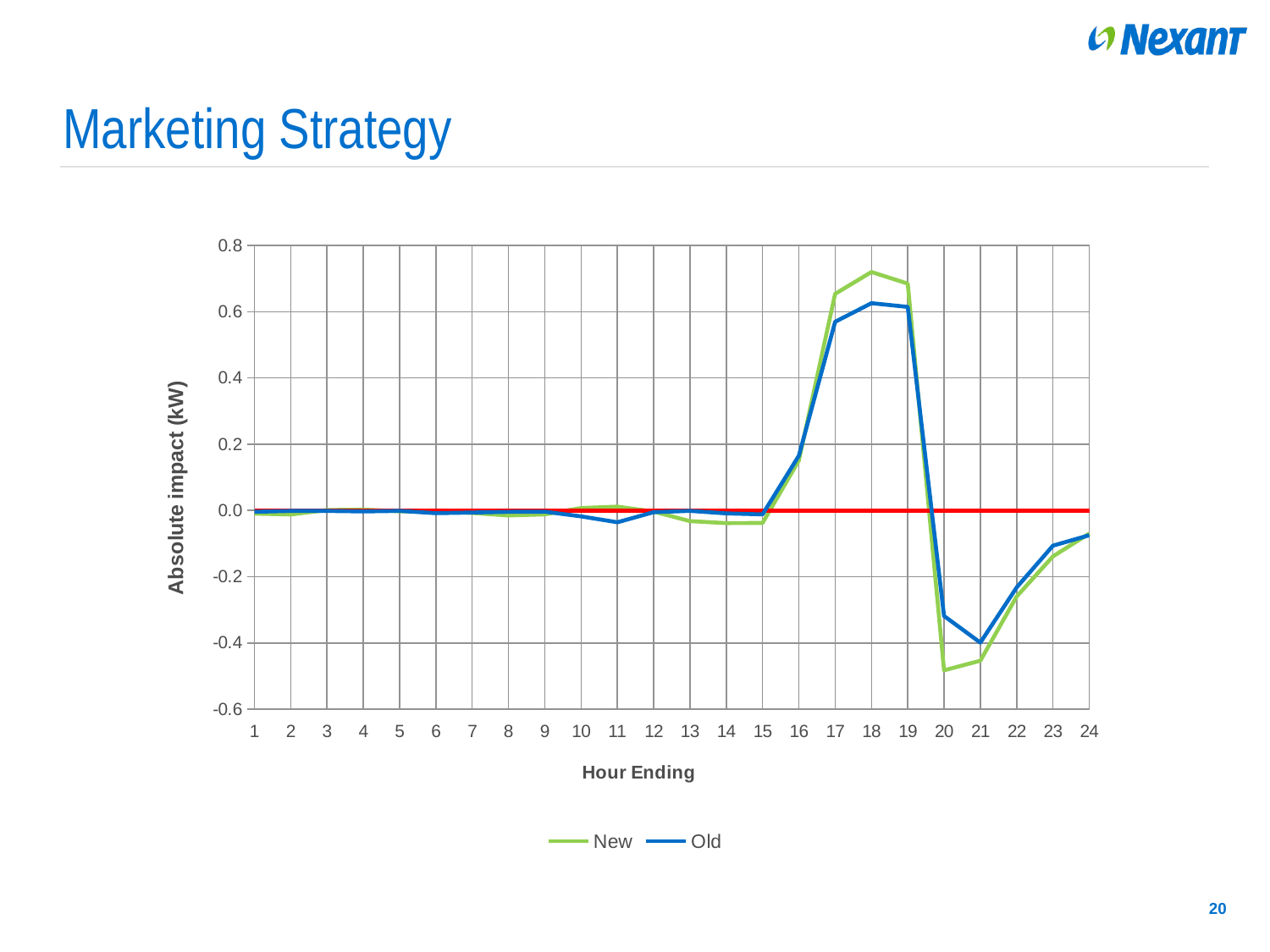
What is the title of the x axis? Hour Ending At hour ending 18, which series has the larger value, New or Old? New At which hour ending does the Old series reach its lowest value? 21 What kind of chart is shown on the slide? Line chart At which hour ending does the New series reach its highest value? 18 Is the value for the New series at hour ending 20 greater or less than -0.4? less Do the values of the New series rise or fall from hour ending 16 to hour ending 18? Rise Is the value for the Old series at hour ending 20 greater or less than -0.4? greater At which hour ending does the New series reach its lowest value? 20 Is the value for the New series at hour ending 18 greater or less than 0.6? greater How many hours are plotted along the x axis? 24 How many series does the legend list? 2